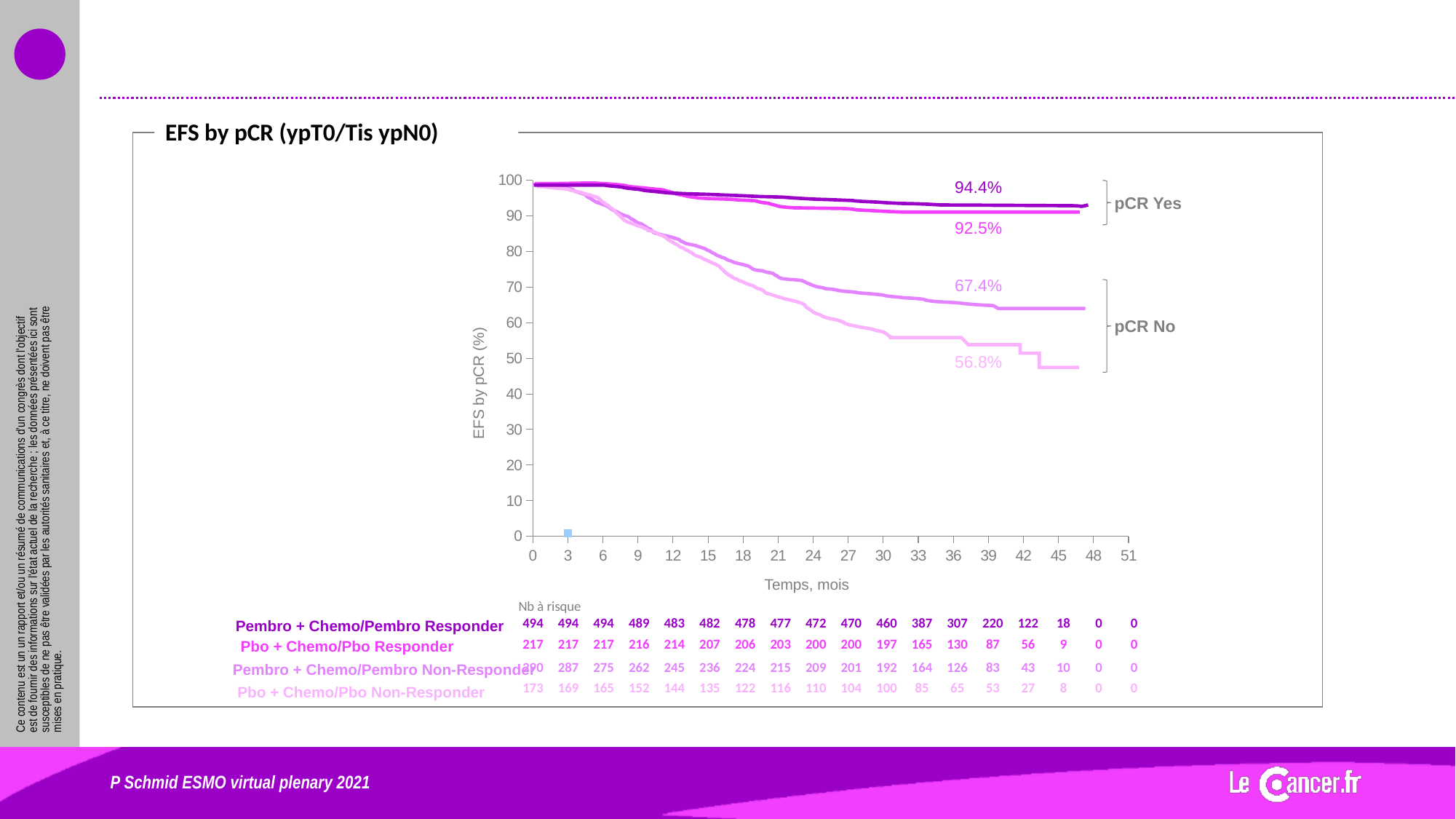
What is the difference between the two EFS percentages labelled for the pCR No group (67.4% and 56.8%)? 10.6 percentage points What kind of chart is shown on the slide? line chart How many patients were at risk at 3 months in the Pbo + Chemo/Pbo Non-Responder group? 169 What is the label of the y axis? EFS by pCR (%) What is the difference between the two EFS percentages labelled for the pCR Yes group (94.4% and 92.5%)? 1.9 percentage points What is the title of the chart? EFS by pCR (ypT0/Tis ypN0) How many patients were at risk at time 0 in the Pembro + Chemo/Pembro Responder group? 494 Which group has higher EFS at the end of follow-up, pCR Yes or pCR No? pCR Yes How many curves are plotted on the chart? 4 Which curve has the highest EFS value labelled at the end of follow-up? Pembro + Chemo/Pembro Responder (94.4%) Is the EFS value for the Pbo + Chemo/Pbo Non-Responder curve at 45 months greater or less than 50? less What is the lowest EFS percentage labelled on the chart? 56.8%